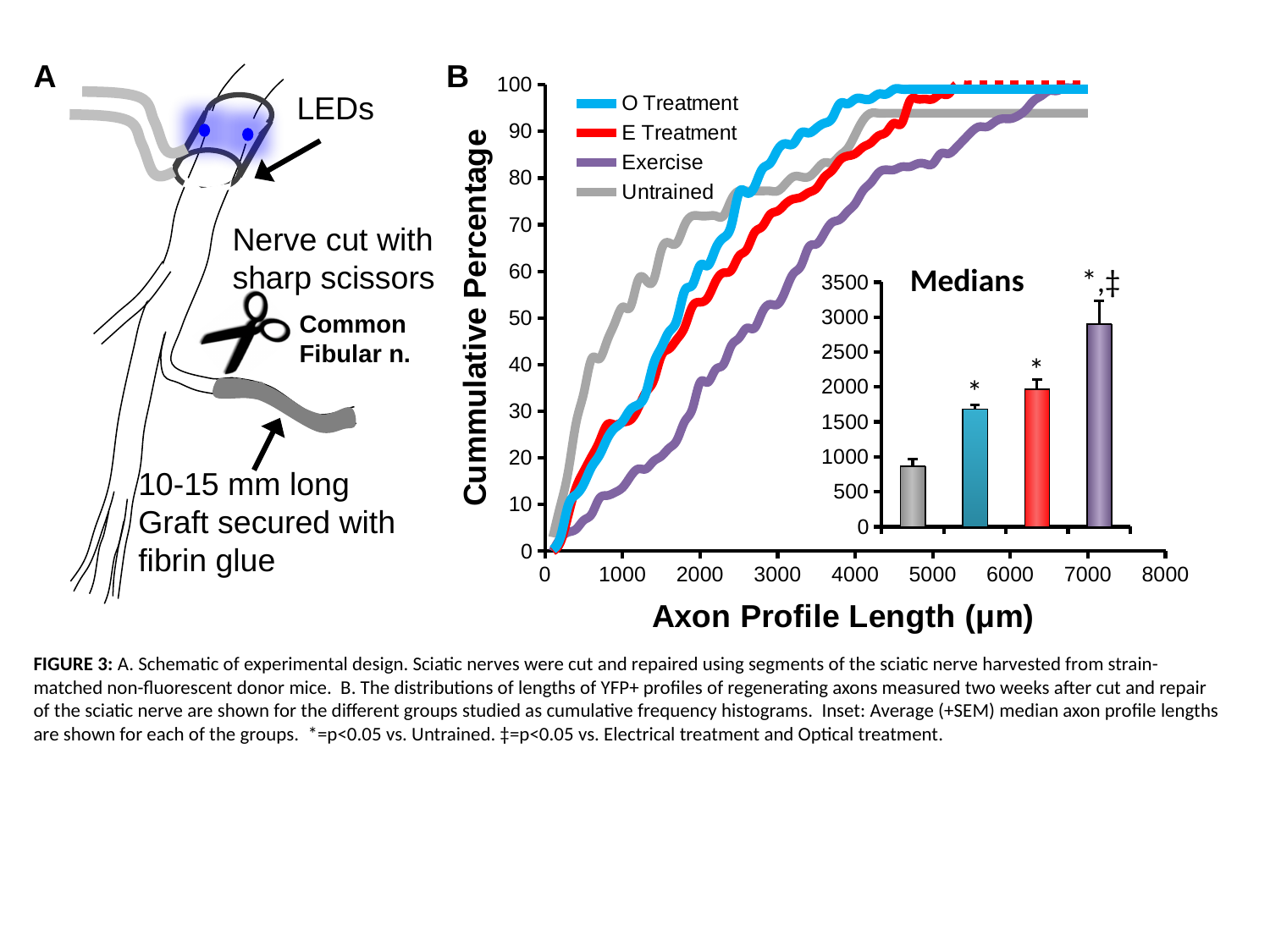
In the Medians inset, which bar is the tallest? the purple bar In the main chart, at an Axon Profile Length of 1000 µm, which line is higher: Untrained or Exercise? Untrained In the Medians inset, which bar is the shortest? the gray bar In the Medians inset, is the value of the purple bar greater or less than 2500? greater How many series does the legend of the cumulative percentage chart list? 4 In the Medians inset, is the value of the gray bar greater or less than 1000? less What is the x-axis title of the main chart? Axon Profile Length (µm) How many bars are shown in the Medians inset chart? 4 What kind of chart is the inset titled Medians? bar chart In the main chart, do the cumulative percentage lines rise or fall as Axon Profile Length increases? rise What kind of chart is the main chart plotting Cummulative Percentage against Axon Profile Length? line chart In the main chart, is the Exercise value at 4000 µm greater or less than 70? greater